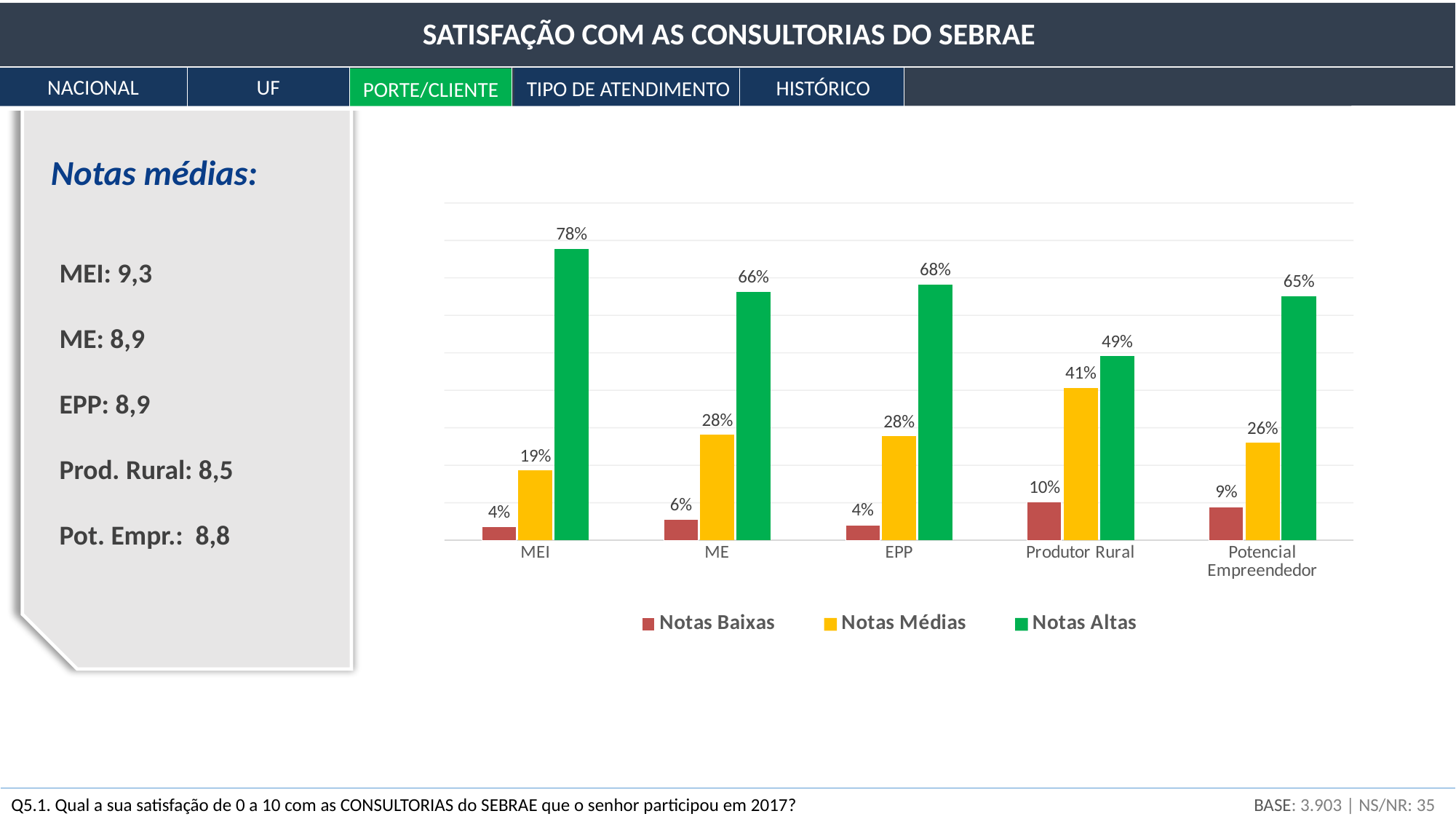
Which category has the lowest Notas Altas value? Produtor Rural What is the difference between Notas Altas for MEI and Notas Altas for Produtor Rural? 29% What kind of chart is shown on the slide? Bar chart Which colour represents the Notas Altas series in the legend? Green Which category has the highest Notas Altas value? MEI Which is larger: Notas Médias for EPP or Notas Médias for Potencial Empreendedor? Notas Médias for EPP What is the total of Notas Baixas and Notas Médias for Produtor Rural? 51% How many series does the legend list? 3 How many categories are shown on the x axis? 5 What is the value of Notas Médias for Produtor Rural? 41% What is the value of Notas Altas for MEI? 78% What is the value of Notas Baixas for ME? 6%